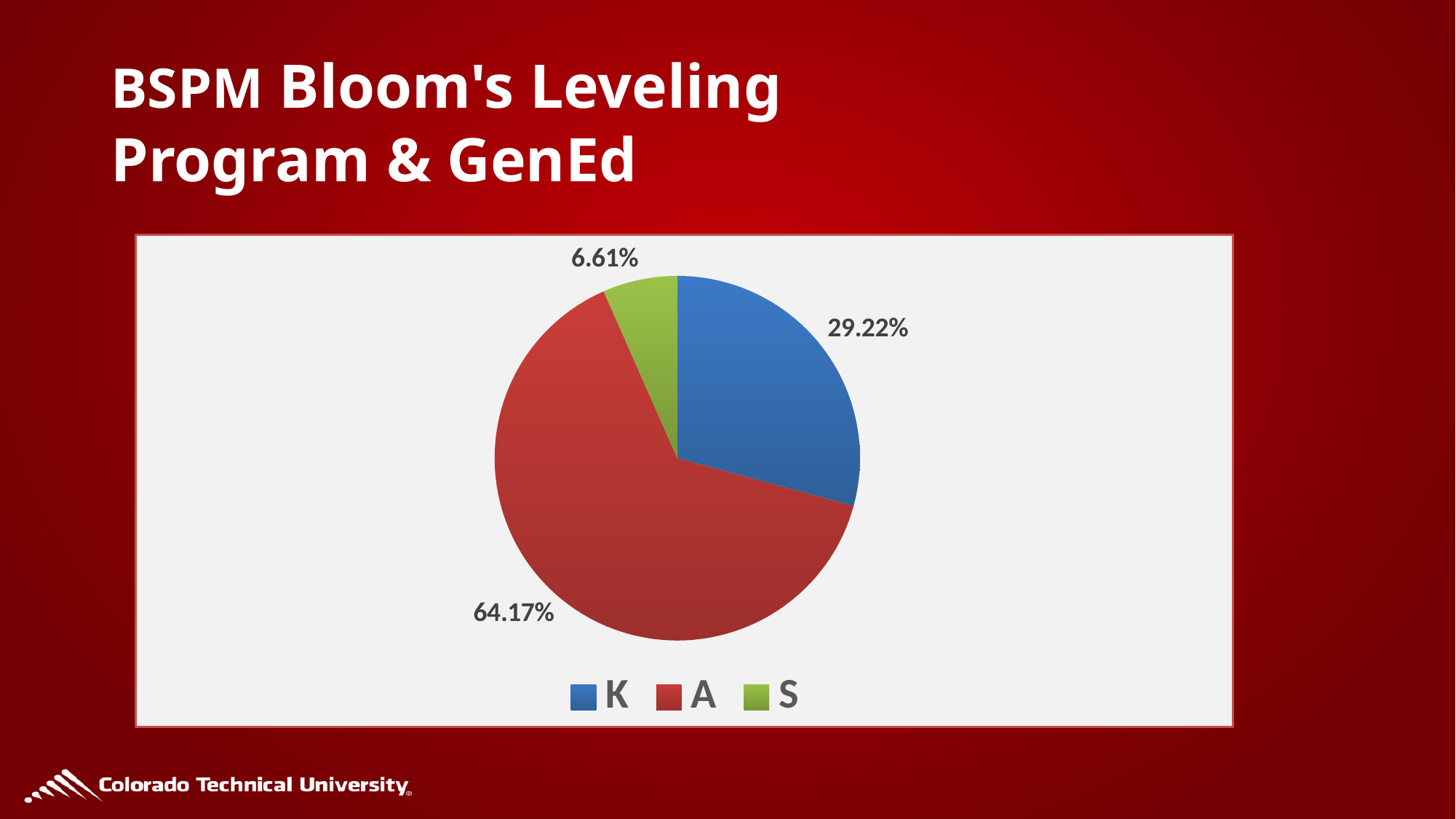
What kind of chart is shown on the slide? pie chart What share of the pie does S represent? 6.61% Which category has the smallest slice of the pie? S How many slices does the pie chart have? 3 Which category has the largest slice of the pie? A What share of the pie does A represent? 64.17% What share of the pie does K represent? 29.22% What is the difference in percentage points between the A slice and the K slice? 34.95 Which slice is larger, K or S? K What colour is the slice for S? green How many entries does the legend list? 3 What colour is the slice for A? red